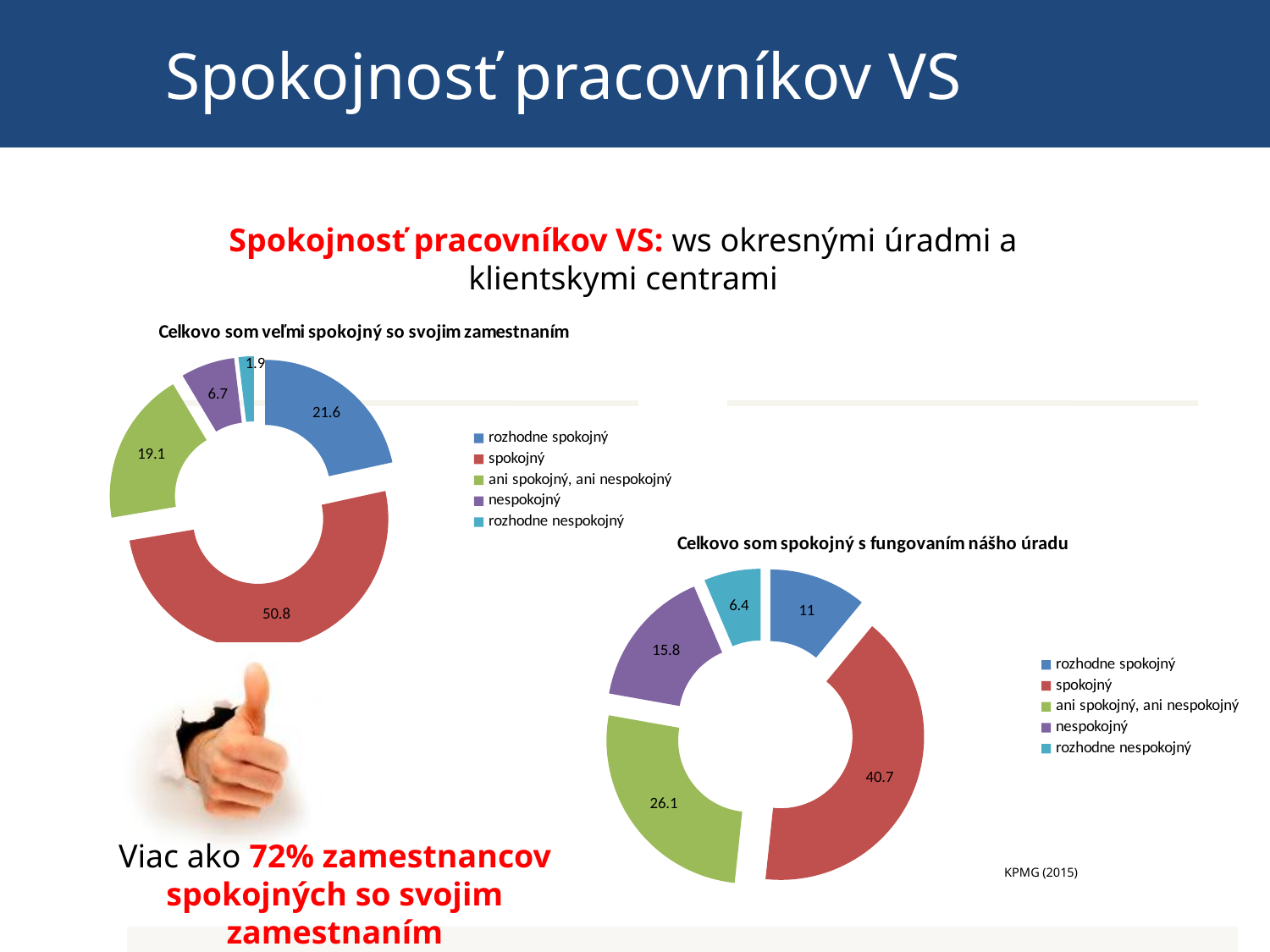
In the chart titled "Celkovo som veľmi spokojný so svojim zamestnaním", what is the difference between the values for "rozhodne spokojný" and "ani spokojný, ani nespokojný"? 2.5 In the chart titled "Celkovo som spokojný s fungovaním nášho úradu", what is the difference between the values for "spokojný" and "ani spokojný, ani nespokojný"? 14.6 In the chart titled "Celkovo som spokojný s fungovaním nášho úradu", which is larger: "ani spokojný, ani nespokojný" or "nespokojný"? ani spokojný, ani nespokojný In the chart titled "Celkovo som veľmi spokojný so svojim zamestnaním", what is the value for "rozhodne nespokojný"? 1.9 What type of chart is the chart titled "Celkovo som veľmi spokojný so svojim zamestnaním"? Doughnut chart In the chart titled "Celkovo som veľmi spokojný so svojim zamestnaním", which category has the lowest value? rozhodne nespokojný In the chart titled "Celkovo som veľmi spokojný so svojim zamestnaním", what is the value for "spokojný"? 50.8 In the chart titled "Celkovo som veľmi spokojný so svojim zamestnaním", which category has the highest value? spokojný How many categories does the legend of the chart titled "Celkovo som spokojný s fungovaním nášho úradu" list? 5 In the chart titled "Celkovo som spokojný s fungovaním nášho úradu", what is the value for "nespokojný"? 15.8 In the chart titled "Celkovo som spokojný s fungovaním nášho úradu", which category has the highest value? spokojný In the chart titled "Celkovo som spokojný s fungovaním nášho úradu", what is the value for "rozhodne spokojný"? 11